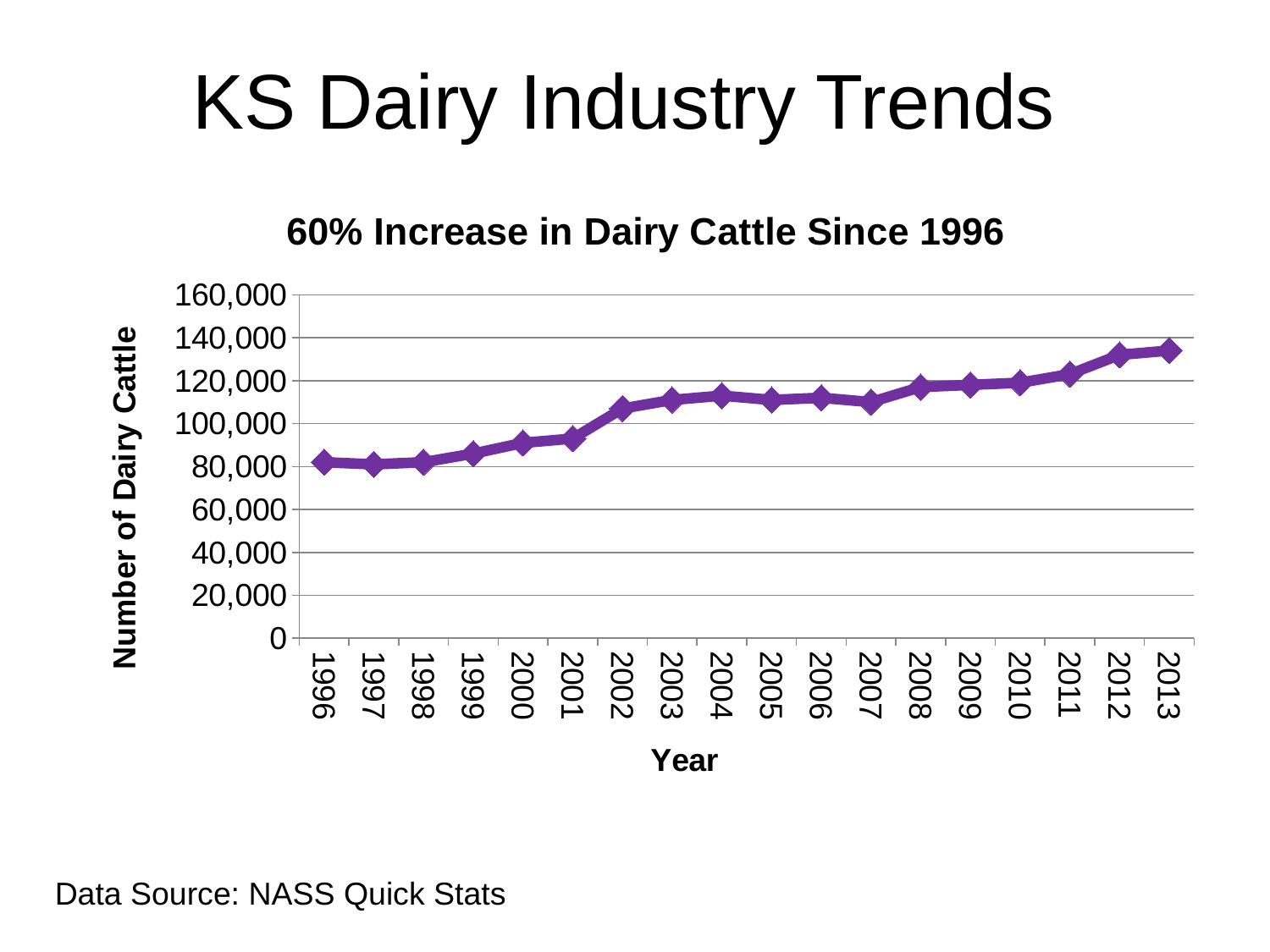
Which year has the highest number of dairy cattle? 2013 Is the value for 2013 greater or less than 120,000? greater What is the label of the vertical axis? Number of Dairy Cattle How many years are plotted on the x axis? 18 Is the value for 2002 greater or less than 100,000? greater What is the title of the chart? 60% Increase in Dairy Cattle Since 1996 Is the value for 1996 greater or less than 100,000? less Which year has the larger number of dairy cattle, 2013 or 1996? 2013 Overall, do the values rise or fall from 1996 to 2013? Rise Which year has the larger number of dairy cattle, 2004 or 2000? 2004 What kind of chart is shown on the slide? Line chart